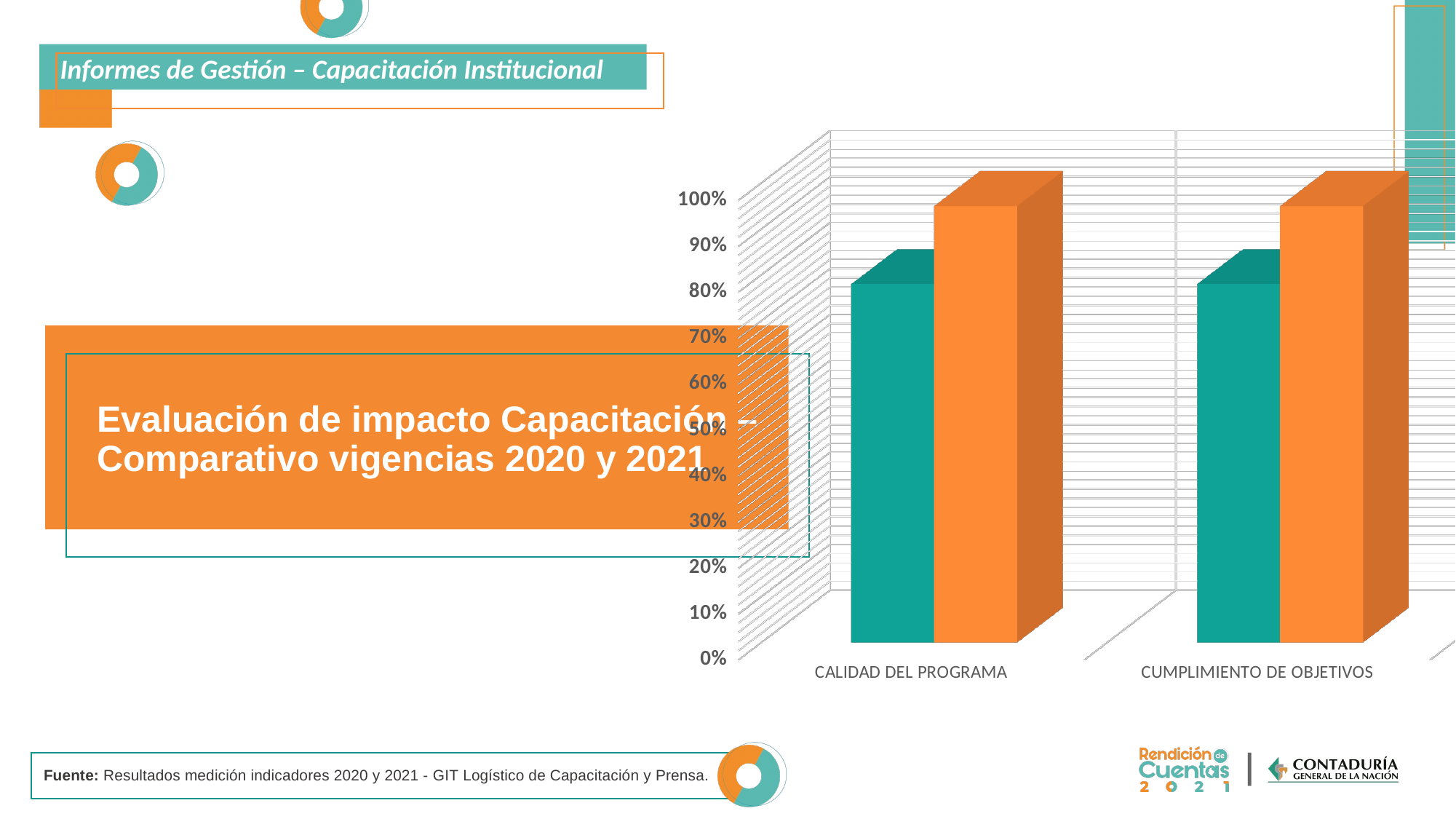
What kind of chart is shown on the slide? Bar chart What are the two categories shown on the x axis of the chart? CALIDAD DEL PROGRAMA and CUMPLIMIENTO DE OBJETIVOS How many categories are shown on the x axis of the chart? 2 For CALIDAD DEL PROGRAMA, is the teal bar greater or less than 90%? less Is the teal bar for CUMPLIMIENTO DE OBJETIVOS greater or less than 100%? less What is the highest value shown on the chart's vertical axis? 100% How many bars are plotted for each category in the chart? 2 For CUMPLIMIENTO DE OBJETIVOS, which bar is taller, the teal one or the orange one? The orange one For CALIDAD DEL PROGRAMA, is the orange bar greater or less than 90%? greater For CALIDAD DEL PROGRAMA, which bar is taller, the teal one or the orange one? The orange one